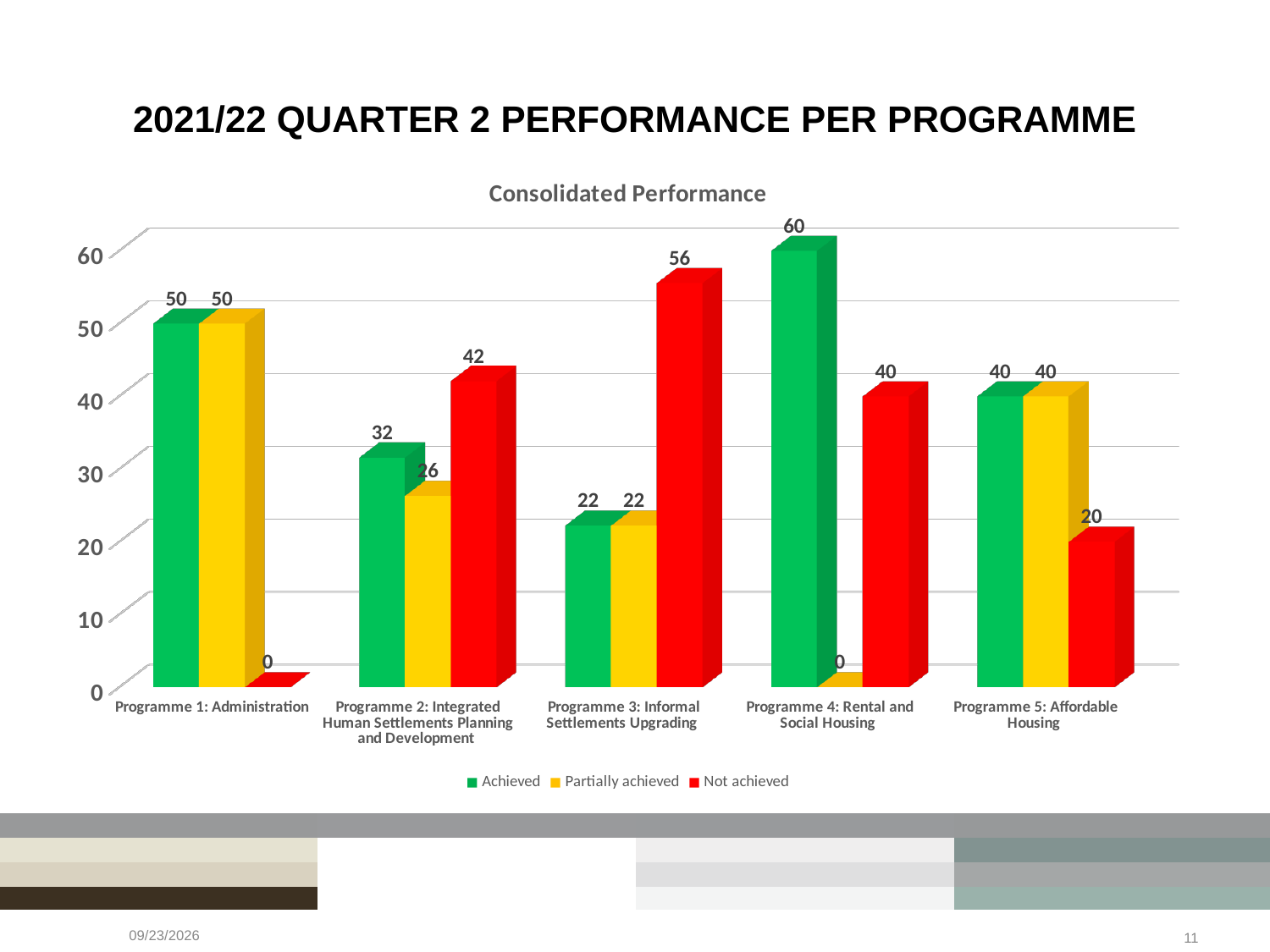
What is the difference between the Not achieved value and the Achieved value for Programme 2: Integrated Human Settlements Planning and Development? 10 Which is larger for Programme 5: Affordable Housing, the Achieved value or the Not achieved value? Achieved What is the Partially achieved value for Programme 2: Integrated Human Settlements Planning and Development? 26 What is the Achieved value for Programme 4: Rental and Social Housing? 60 What kind of chart is shown on the slide? Bar chart Which programme has the lowest Partially achieved value? Programme 4: Rental and Social Housing Which programme has the highest Achieved value? Programme 4: Rental and Social Housing How many programmes are shown on the x axis? 5 How many series does the legend list? 3 What is the title of the chart? Consolidated Performance What is the Not achieved value for Programme 1: Administration? 0 What is the Not achieved value for Programme 3: Informal Settlements Upgrading? 56